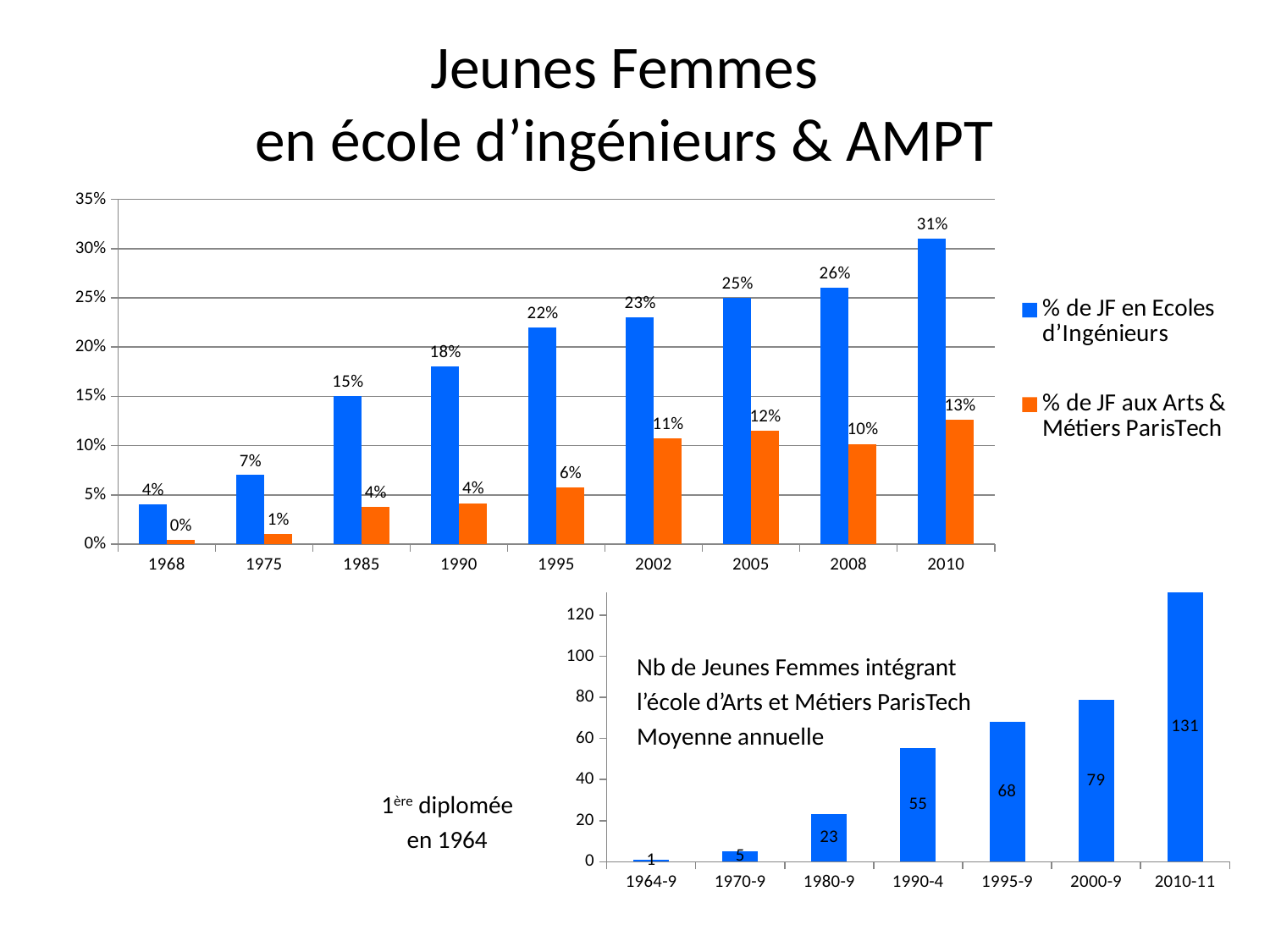
In the top chart, what is the value for % de JF aux Arts & Métiers ParisTech in 1995? 6% In the bottom chart, what is the value for 2000-9? 79 In the top chart, what is the difference between % de JF en Ecoles d'Ingénieurs and % de JF aux Arts & Métiers ParisTech in 2008? 16% In the bottom chart, what is the difference between the values for 2010-11 and 1995-9? 63 What kind of chart is the bottom chart? bar chart In the top chart, how many series does the legend list? 2 In the top chart, do the values for % de JF en Ecoles d'Ingénieurs rise or fall from 1968 to 2010? rise In the bottom chart, which period has the highest value? 2010-11 In the top chart, what is the value for % de JF en Ecoles d'Ingénieurs in 2010? 31% In the top chart, which year has the highest value for % de JF aux Arts & Métiers ParisTech? 2010 In the top chart, which year has the lowest value for % de JF en Ecoles d'Ingénieurs? 1968 In the top chart, how many years are shown on the x axis? 9